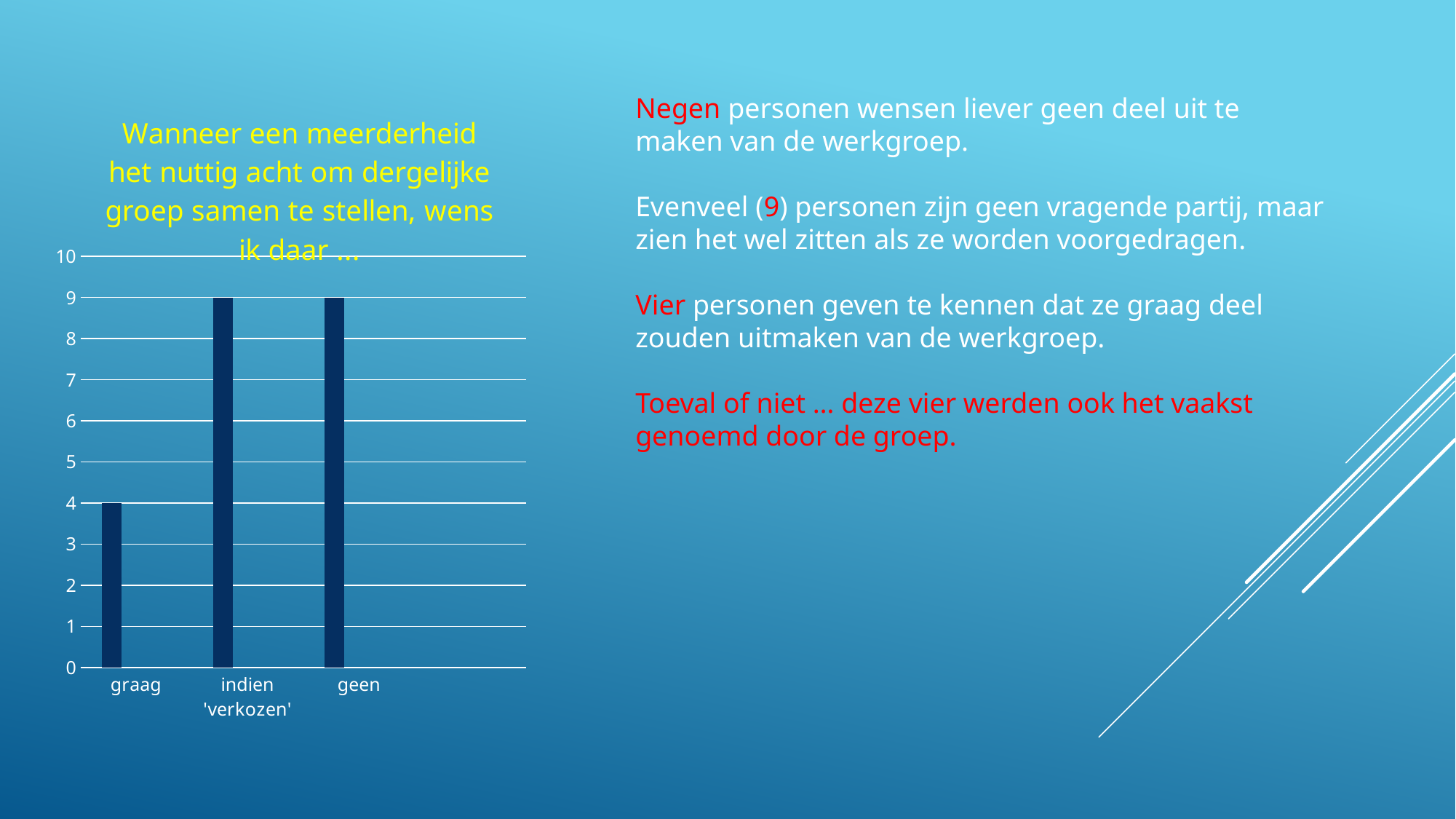
Which is larger, the value for 'graag' or the value for 'geen'? geen Is the value for 'indien 'verkozen'' greater or less than 8? greater Which category has the lowest value? graag What is the value for 'geen'? 9 How many categories are shown on the x axis? 3 What is the value for 'graag'? 4 Is the value for 'graag' greater or less than 5? less Do the values for 'indien 'verkozen'' and 'geen' differ? No, both are 9 What kind of chart is shown on the slide? bar chart What is the highest value shown on the y axis? 10 What is the value for 'indien 'verkozen''? 9 What is the difference between the values for 'geen' and 'graag'? 5